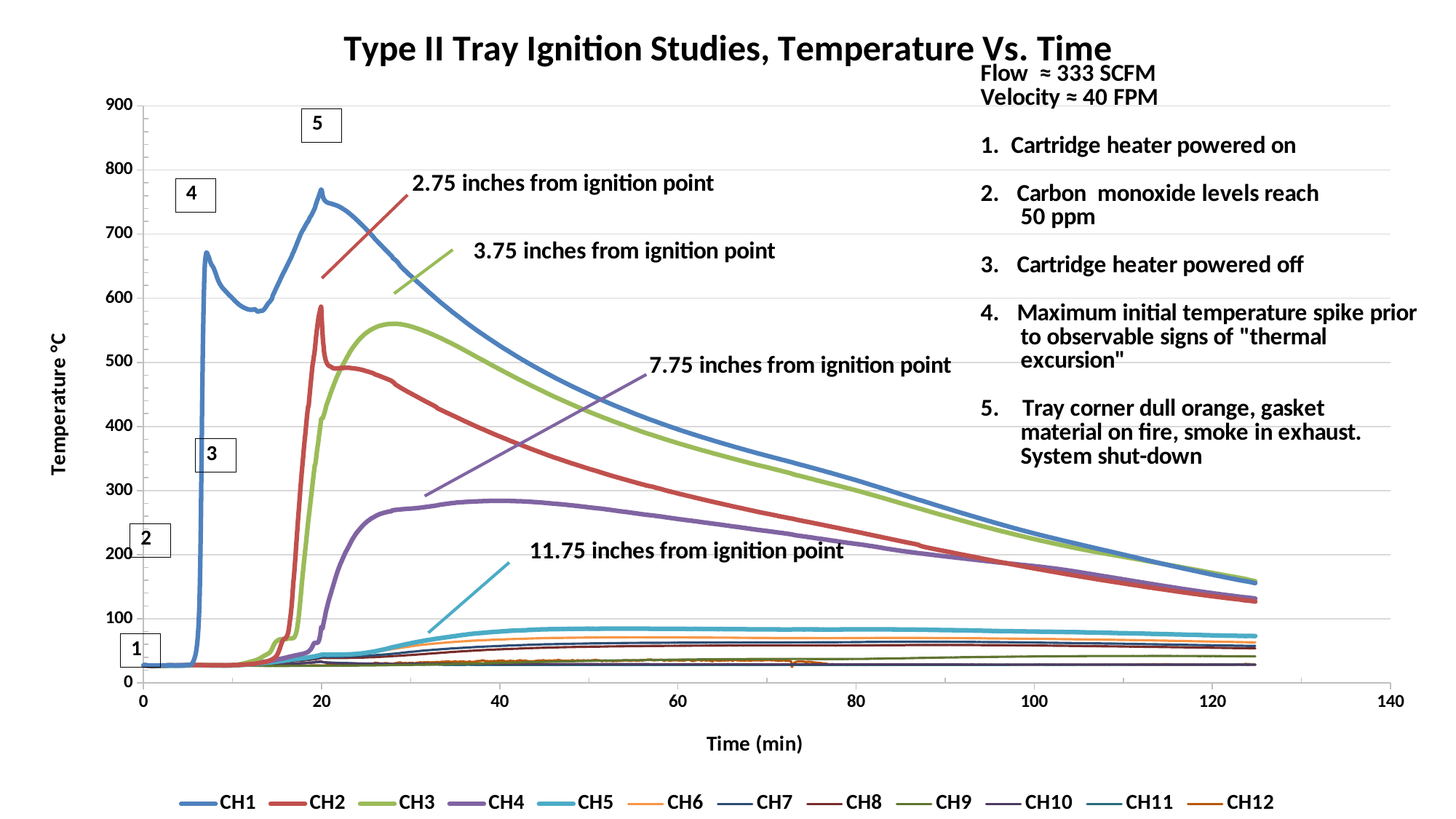
Is the peak value of CH2 greater or less than 600? less What kind of chart is shown on the slide? line chart Which series is annotated as "7.75 inches from ignition point"? CH4 What is the title of the chart? Type II Tray Ignition Studies, Temperature Vs. Time Is the value of CH5 at 100 minutes greater or less than 100? less Which series reaches the highest temperature on the chart? CH1 Is the peak value of CH3 greater or less than 500? greater After about 20 minutes, does the CH1 temperature rise or fall as time increases? fall How many series does the legend list? 12 At 60 minutes, which series has the higher temperature, CH2 or CH3? CH3